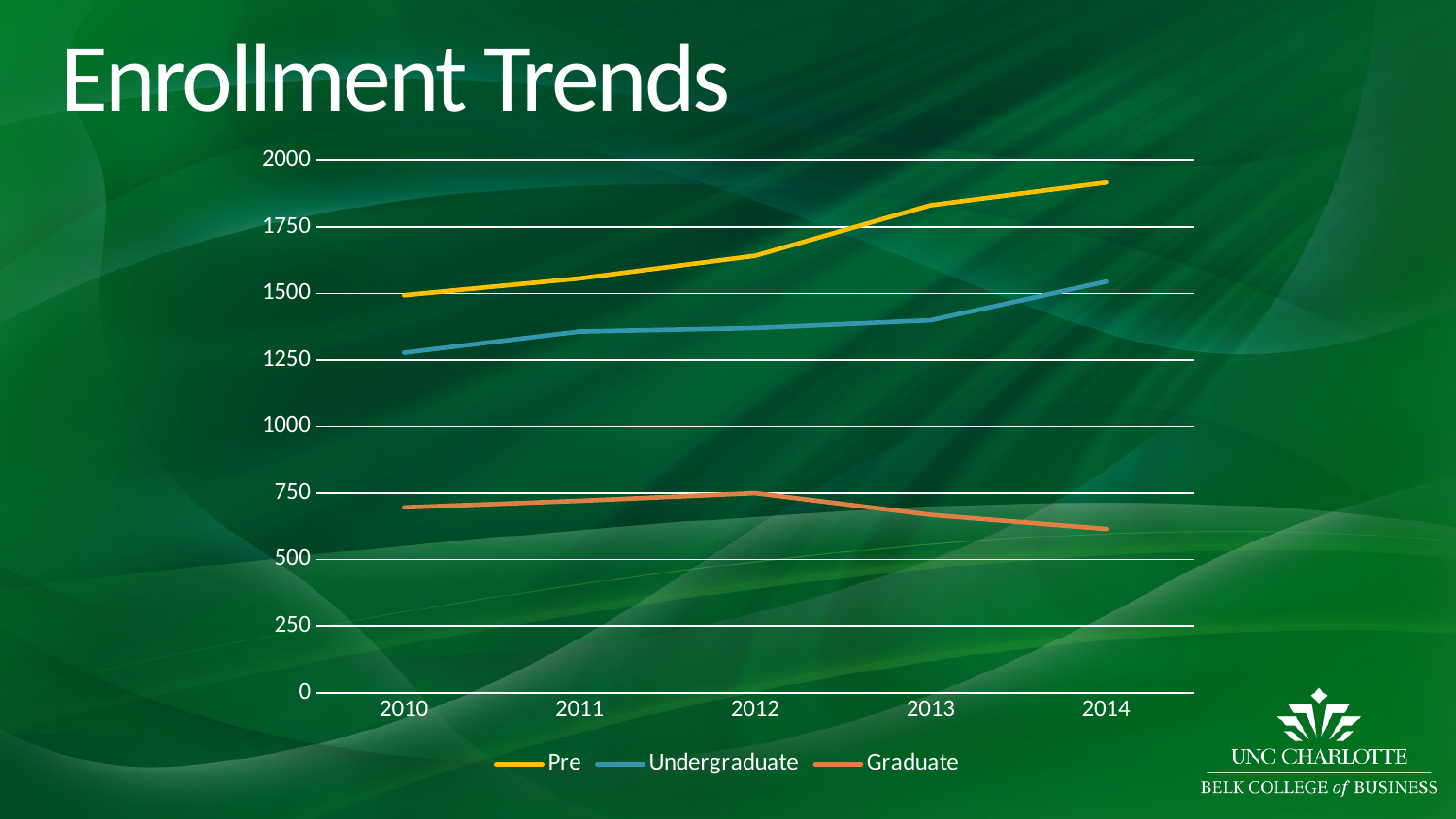
What is the title of the chart? Enrollment Trends In 2013, which is larger, Pre or Undergraduate? Pre In which year is the Pre series at its highest? 2014 Is the value for Pre in 2014 greater or less than 1750? greater Is the value for Undergraduate in 2013 greater or less than 1500? less In which year is the Graduate series at its lowest? 2014 Does the Pre series rise or fall from 2010 to 2014? rise Which series is drawn in orange according to the legend? Graduate How many series does the legend list? 3 How many years are shown on the x axis? 5 Which series has the highest values across all years? Pre What kind of chart is shown on the slide? line chart